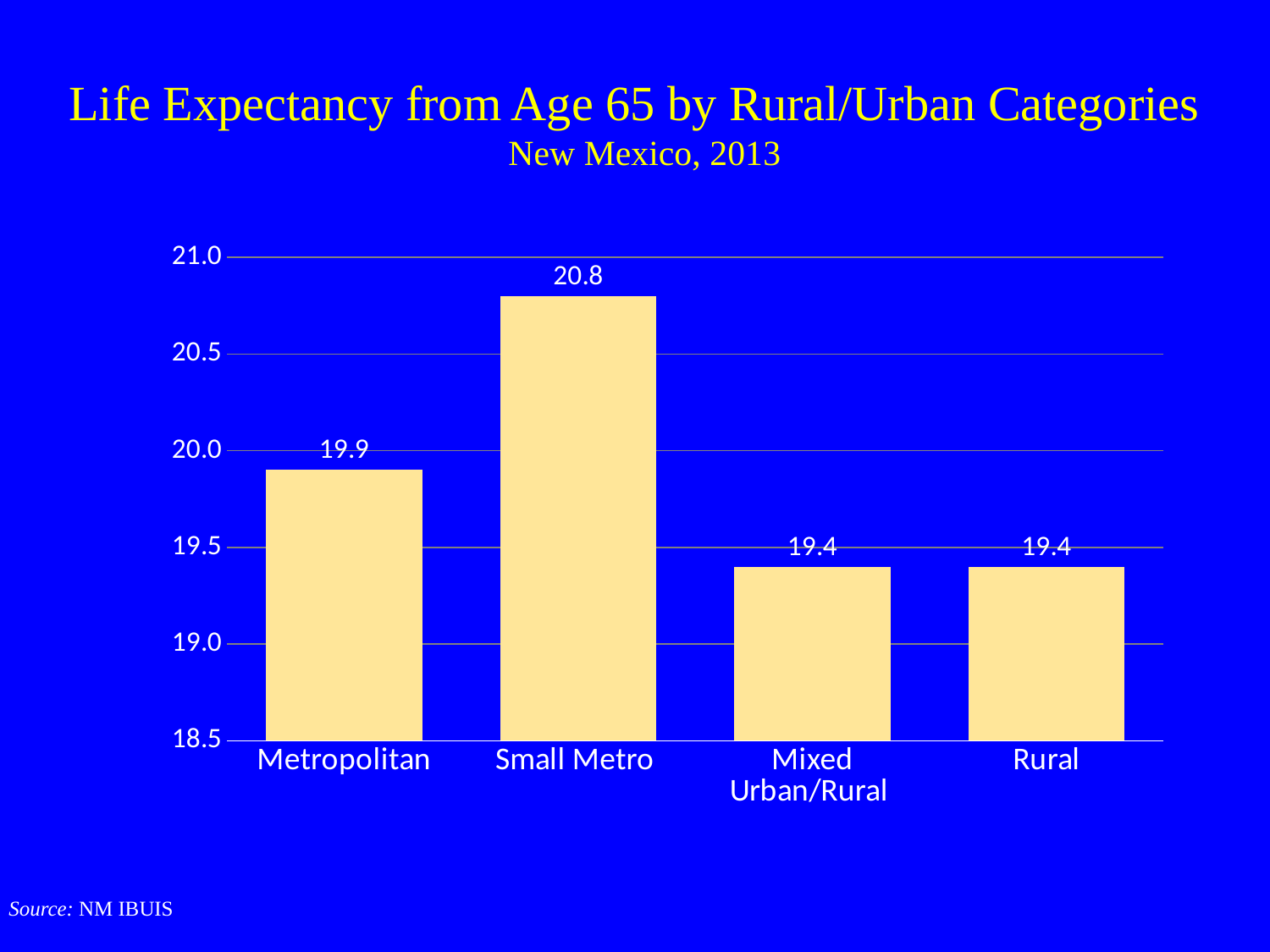
What is the life expectancy from age 65 for Small Metro? 20.8 Is the value for Small Metro greater or less than 20.5? greater What kind of chart is shown on the slide? Bar chart Is the value for Mixed Urban/Rural greater or less than 19.5? less What is the life expectancy from age 65 for Metropolitan? 19.9 What is the difference between the Small Metro and Metropolitan values? 0.9 What is the difference between the Metropolitan and Mixed Urban/Rural values? 0.5 Which category has the highest life expectancy from age 65? Small Metro What is the title of the chart? Life Expectancy from Age 65 by Rural/Urban Categories, New Mexico, 2013 What is the life expectancy from age 65 for Rural? 19.4 How many categories are shown on the chart? 4 Which is larger, the value for Metropolitan or the value for Rural? Metropolitan